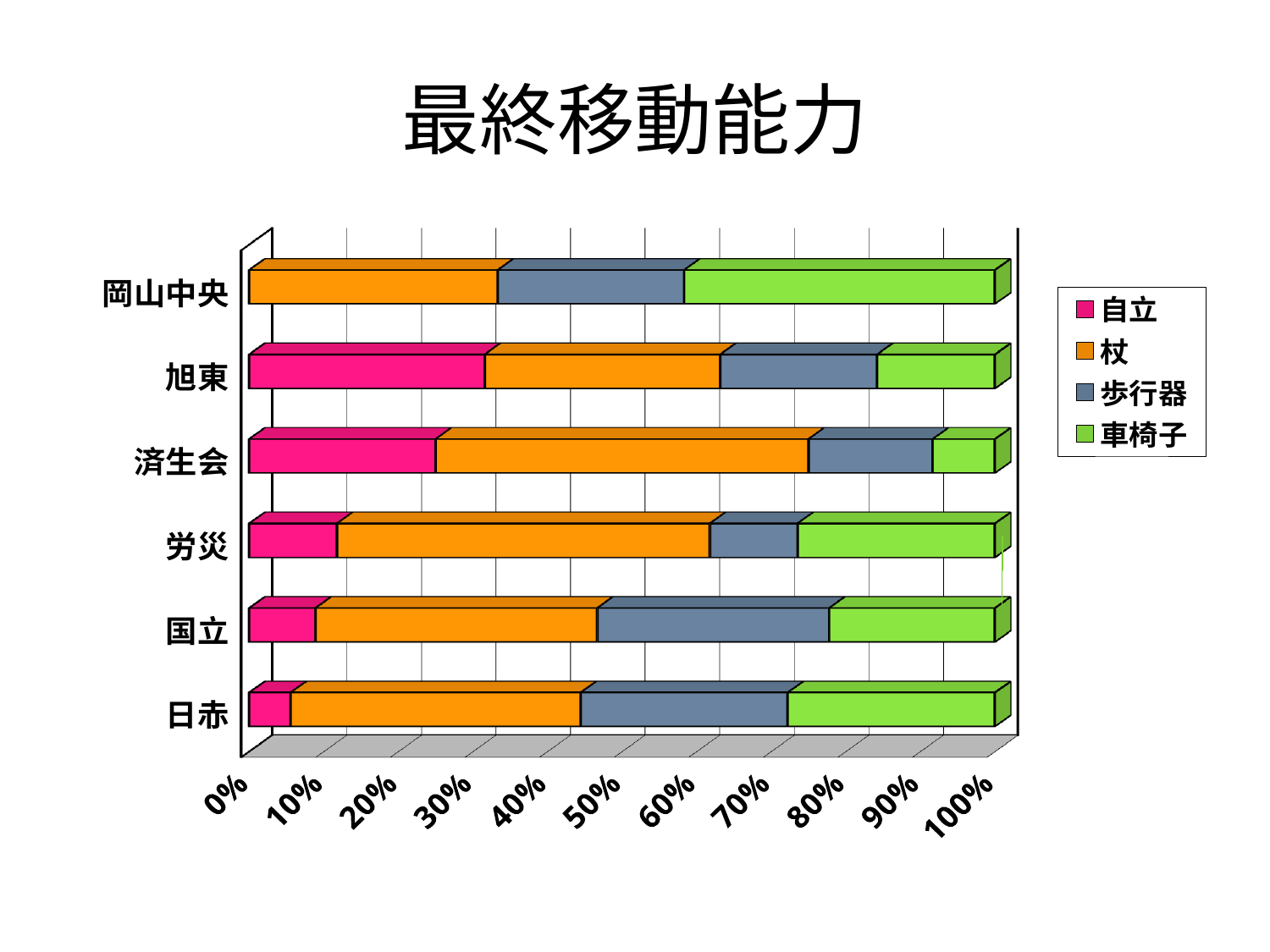
What is the title of the chart? 最終移動能力 Which hospital has the largest 自立 share? 旭東 What kind of chart is shown on the slide? Stacked bar chart How many hospitals (categories) are shown on the vertical axis? 6 How many series does the legend list? 4 Is the 自立 share for 旭東 greater or less than 20%? greater Which legend entry is shown in green? 車椅子 Which hospital has the smallest 自立 share? 岡山中央 Which hospital has the largest 車椅子 share? 岡山中央 Is the 自立 share for 日赤 greater or less than 10%? less Which is larger, the 歩行器 share for 国立 or for 労災? 国立 Which hospital has the smallest 車椅子 share? 済生会